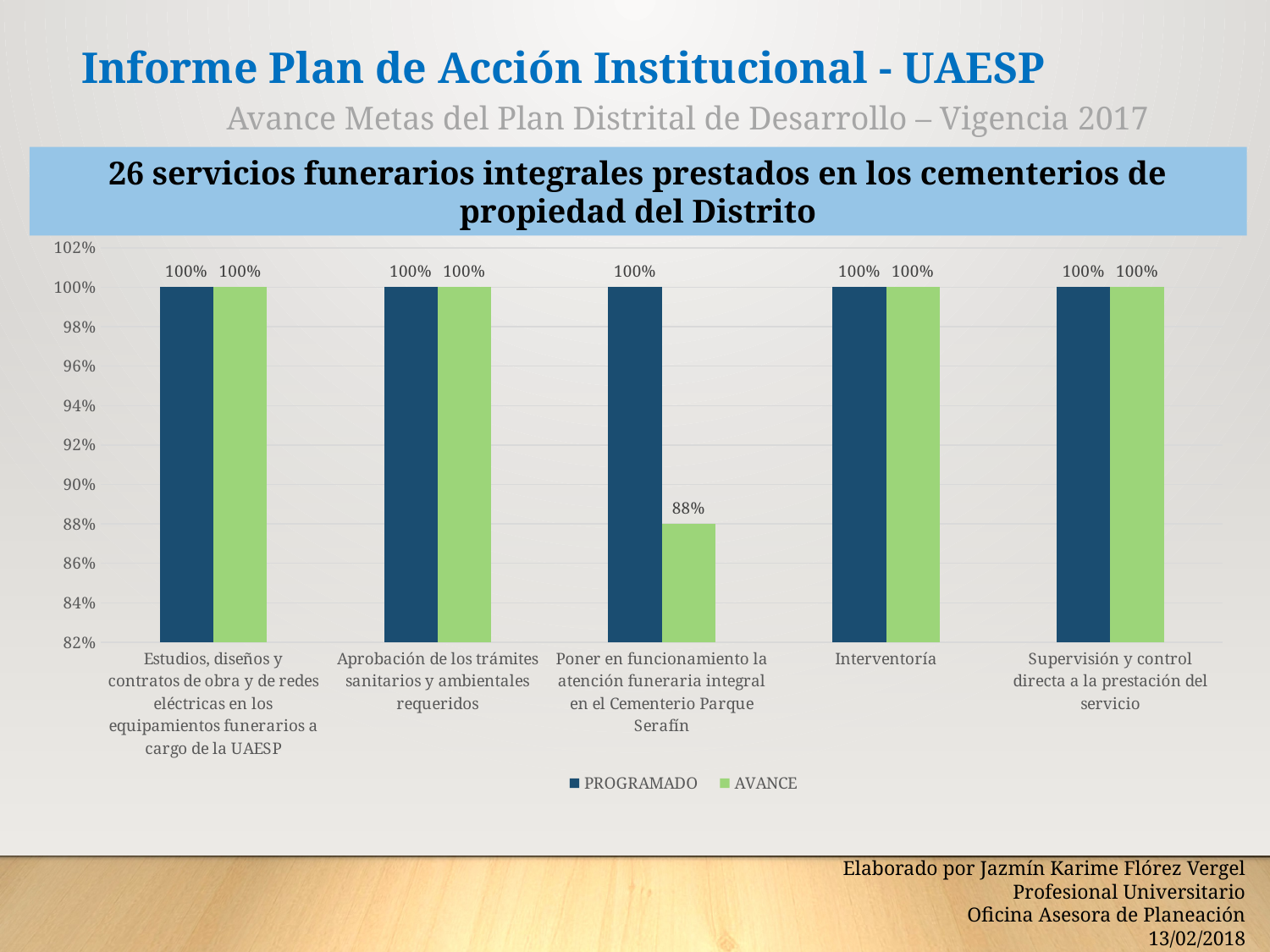
For "Poner en funcionamiento la atención funeraria integral en el Cementerio Parque Serafín", which is larger, PROGRAMADO or AVANCE? PROGRAMADO What kind of chart is shown on the slide? bar chart What is the title of the chart? 26 servicios funerarios integrales prestados en los cementerios de propiedad del Distrito What are the two series named in the legend? PROGRAMADO and AVANCE What is the AVANCE value for "Supervisión y control directa a la prestación del servicio"? 100% Is the AVANCE value for "Poner en funcionamiento la atención funeraria integral en el Cementerio Parque Serafín" greater or less than 90%? less What is the PROGRAMADO value for "Interventoría"? 100% What is the AVANCE value for "Poner en funcionamiento la atención funeraria integral en el Cementerio Parque Serafín"? 88% How many series does the legend list? 2 What is the difference between the PROGRAMADO and AVANCE values for "Poner en funcionamiento la atención funeraria integral en el Cementerio Parque Serafín"? 12% Which category has the lowest AVANCE value? Poner en funcionamiento la atención funeraria integral en el Cementerio Parque Serafín How many categories are shown on the x axis? 5